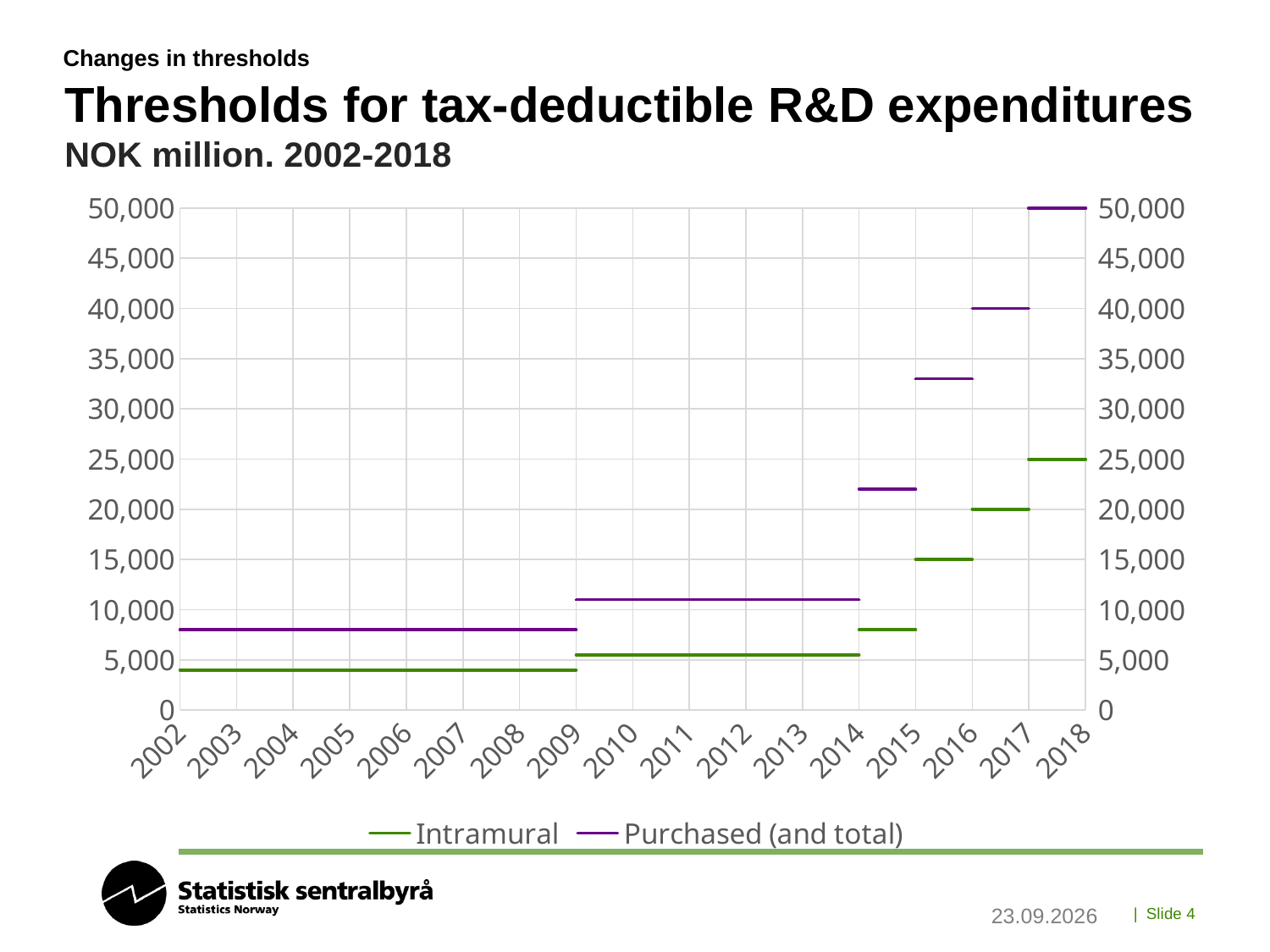
Is the Purchased (and total) value for 2015 greater or less than 30,000? greater Which series is higher in 2014, Intramural or Purchased (and total)? Purchased (and total) Do the Intramural thresholds rise or fall from 2002 to 2018? rise How many series does the legend list? 2 What is the Intramural threshold in 2017? 25,000 What kind of chart is shown on the slide? line chart What is the Purchased (and total) threshold in 2017? 50,000 What is the difference between the Purchased (and total) and Intramural thresholds in 2017? 25,000 What is the Purchased (and total) threshold in 2016? 40,000 Is the Intramural value for 2002 greater or less than 5,000? less What is the Intramural threshold in 2016? 20,000 How many years are labelled on the x axis? 17